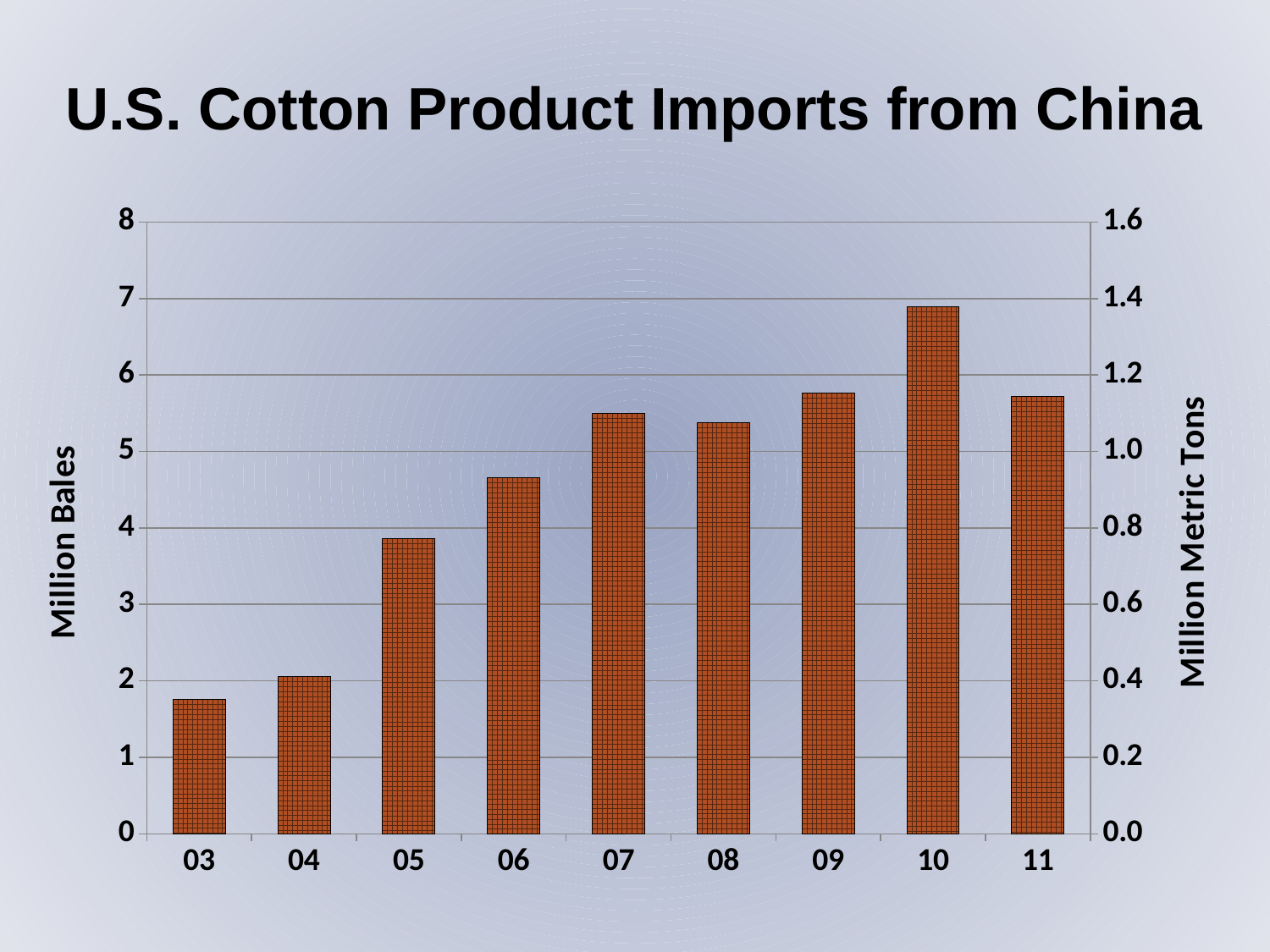
Is the value for 03 greater or less than 2 million bales? less What kind of chart is shown on the slide? bar chart Is the value for 10 greater or less than 6 million bales? greater Which year has the highest value? 10 Which is larger, the value for 05 or the value for 06? 06 Is the value for 05 greater or less than 4 million bales? less Which year has the lowest value? 03 What is the label on the right-hand vertical axis? Million Metric Tons Do the values rise or fall from 03 to 07? rise How many years are plotted on the chart? 9